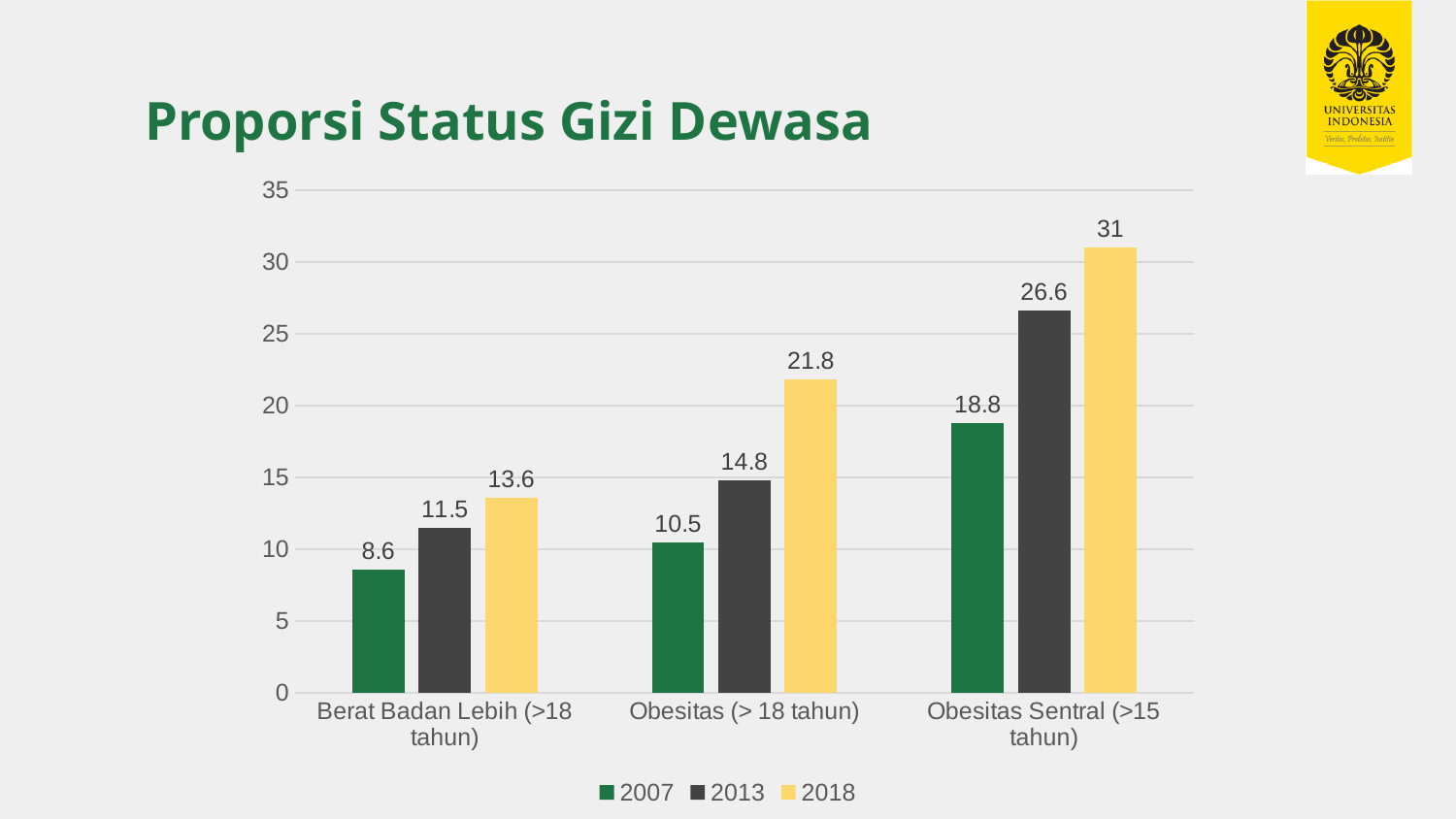
What kind of chart is shown on the slide? bar chart What is the difference between the 2018 and 2007 values for Obesitas (> 18 tahun)? 11.3 How many series does the legend list? 3 Is the 2013 value for Berat Badan Lebih (>18 tahun) greater or less than 15? less What is the value for Berat Badan Lebih (>18 tahun) in 2007? 8.6 Do the values for Obesitas Sentral (>15 tahun) rise or fall from 2007 to 2018? rise Which is larger: the 2013 value for Obesitas Sentral (>15 tahun) or the 2018 value for Obesitas (> 18 tahun)? 2013 value for Obesitas Sentral (>15 tahun) How many categories are shown on the x axis? 3 What is the value for Obesitas (> 18 tahun) in 2013? 14.8 Which category has the lowest value in 2007? Berat Badan Lebih (>18 tahun) Which category has the highest value in 2018? Obesitas Sentral (>15 tahun) What is the value for Obesitas Sentral (>15 tahun) in 2018? 31